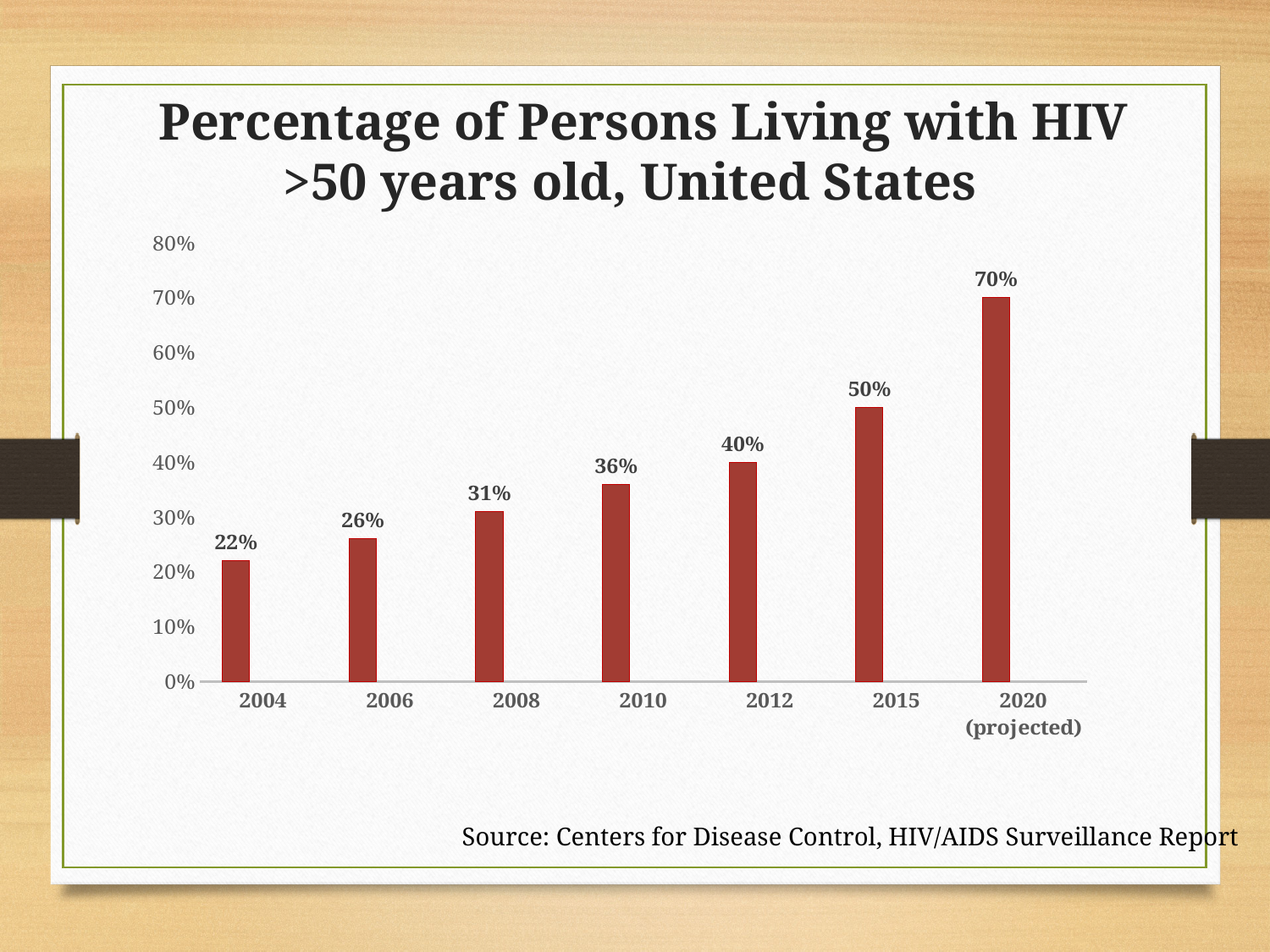
What is the value for 2010? 36% What kind of chart is this? bar chart Which year has the lowest value? 2004 What is the value for 2020 (projected)? 70% How many years are shown on the x axis? 7 Which is larger, the value for 2008 or the value for 2006? 2008 Which year has the highest value? 2020 (projected) Do the values rise or fall from 2004 to 2020 (projected)? rise What is the value for 2004? 22% What is the difference between the values for 2020 (projected) and 2004? 48% What is the difference between the values for 2015 and 2012? 10% Is the value for 2015 greater or less than 40%? greater